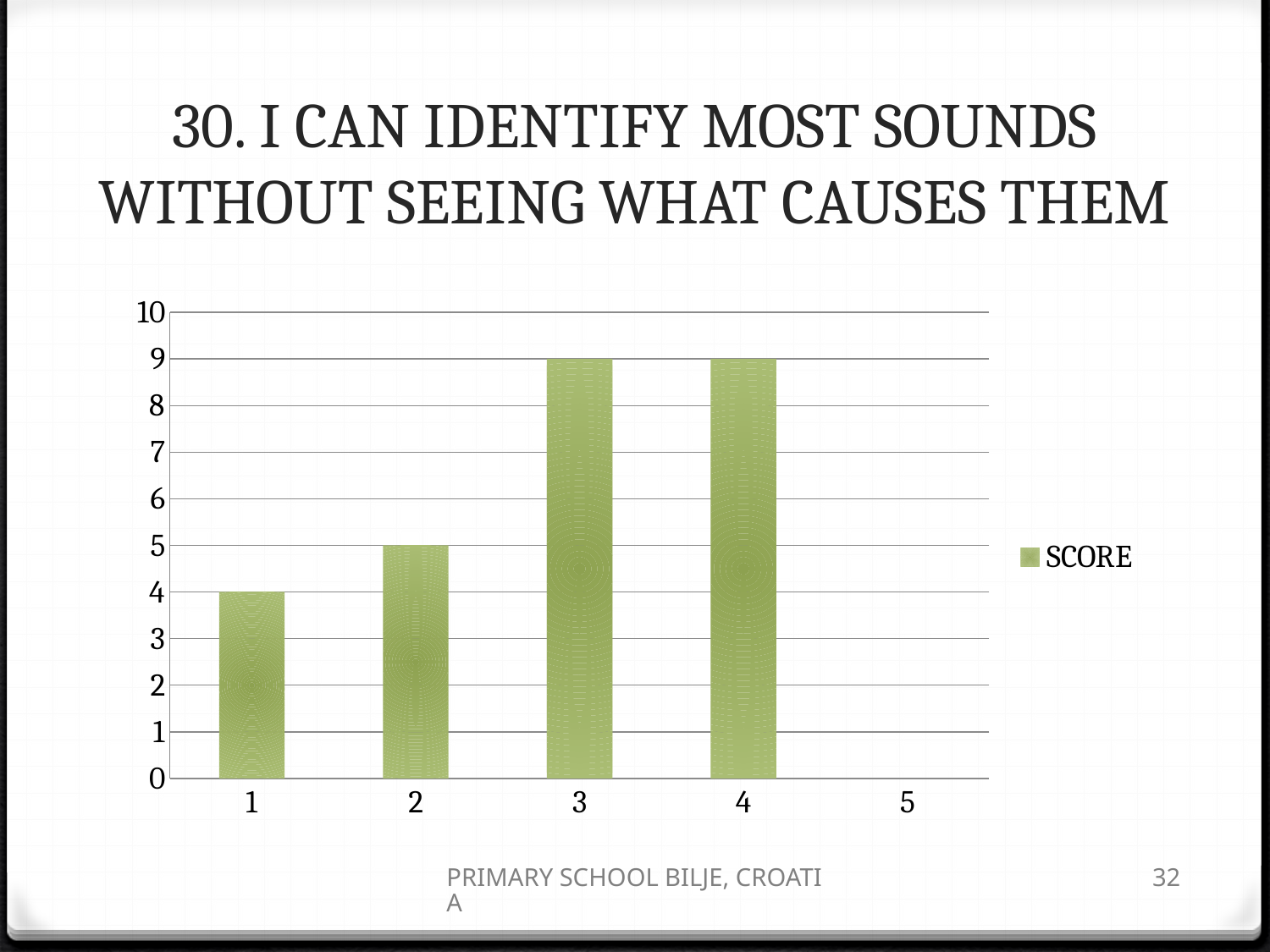
What is the difference between the SCORE values for category 3 and category 1? 5 What kind of chart is shown on the slide? bar chart How many categories are shown on the x axis? 5 What is the SCORE value for category 2? 5 What is the name of the series shown in the legend? SCORE Is the SCORE value for category 4 greater or less than 7? greater Which category has the lowest SCORE value? 5 Which has a larger SCORE value, category 2 or category 3? 3 How many series does the legend list? 1 What is the SCORE value for category 3? 9 What is the SCORE value for category 4? 9 What is the SCORE value for category 1? 4